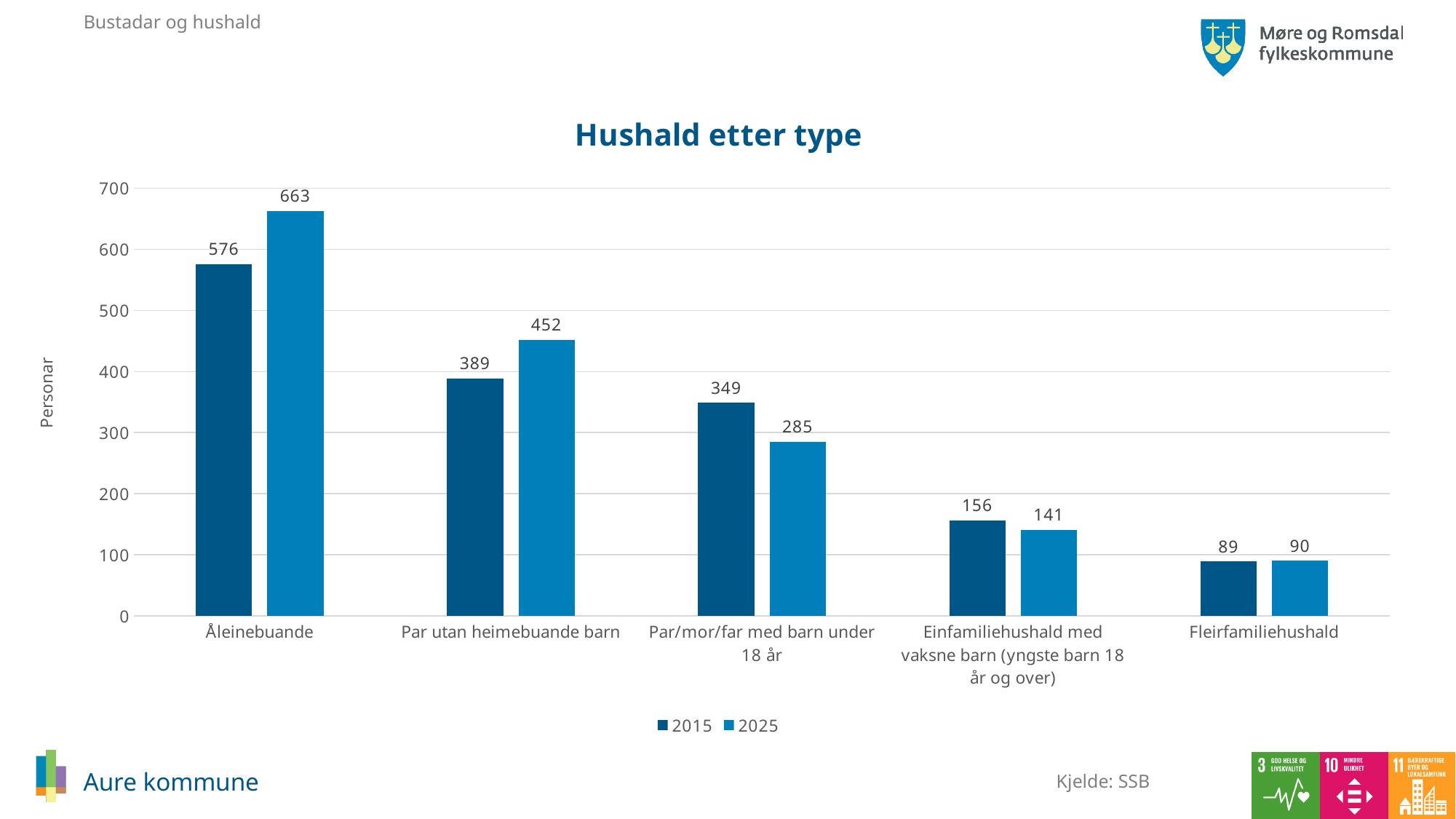
Is the 2025 value for Par utan heimebuande barn greater or less than 400? greater What is the difference between the 2025 and 2015 values for Åleinebuande? 87 How many household types are shown on the x axis? 5 What is the value for Åleinebuande in 2025? 663 Which household type has the highest value in 2015? Åleinebuande How many series does the legend list? 2 What kind of chart is shown? Bar chart Which household type has the lowest value in 2025? Fleirfamiliehushald What is the value for Einfamiliehushald med vaksne barn (yngste barn 18 år og over) in 2025? 141 What is the value for Par utan heimebuande barn in 2015? 389 What is the title of the chart? Hushald etter type Which is larger for Par/mor/far med barn under 18 år: the 2015 value or the 2025 value? 2015